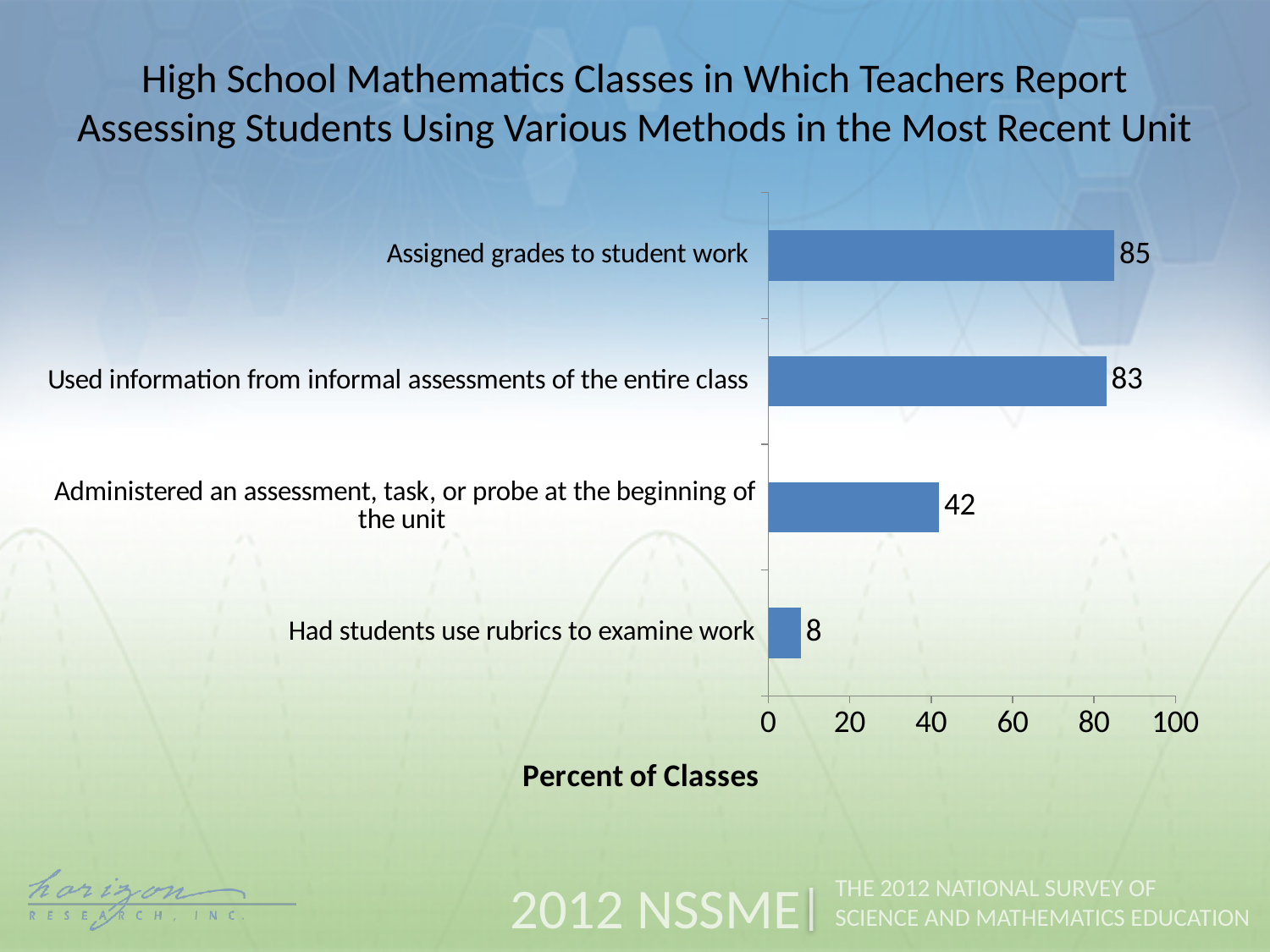
What is the value for 'Had students use rubrics to examine work'? 8 What is the value for 'Used information from informal assessments of the entire class'? 83 What is the label of the horizontal axis? Percent of Classes Which assessment method has the highest percent of classes? Assigned grades to student work What kind of chart is shown on the slide? Bar chart What percent of classes administered an assessment, task, or probe at the beginning of the unit? 42 Which is larger: the value for 'Administered an assessment, task, or probe at the beginning of the unit' or the value for 'Had students use rubrics to examine work'? Administered an assessment, task, or probe at the beginning of the unit How many assessment methods are shown in the chart? 4 Which assessment method has the lowest percent of classes? Had students use rubrics to examine work What is the difference between the value for 'Assigned grades to student work' and the value for 'Had students use rubrics to examine work'? 77 What is the difference between the value for 'Used information from informal assessments of the entire class' and the value for 'Administered an assessment, task, or probe at the beginning of the unit'? 41 What percent of classes had teachers who assigned grades to student work? 85